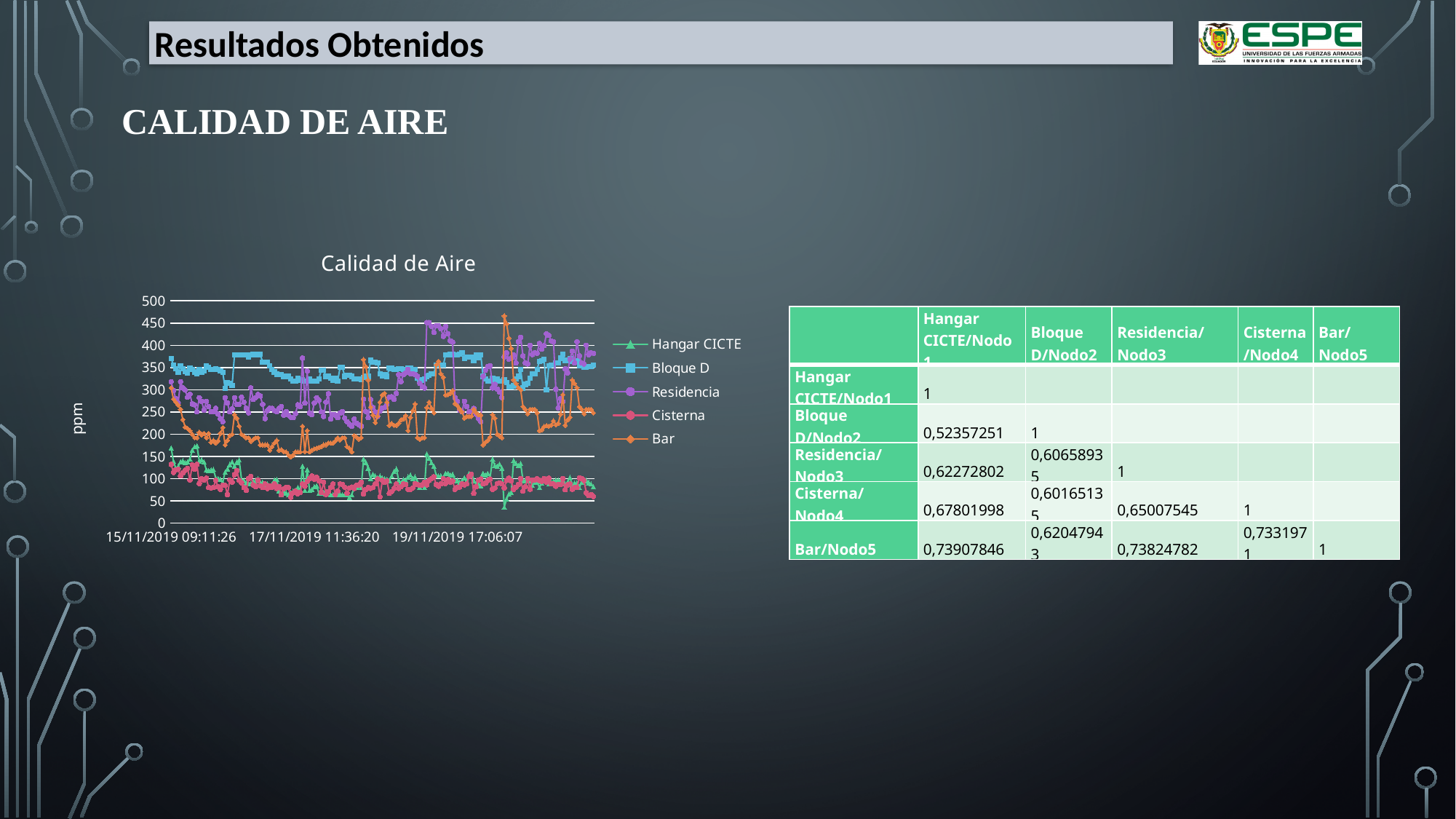
What kind of chart is shown on the slide? line chart What label is shown on the vertical axis of the chart? ppm How many date labels are shown on the horizontal axis of the chart? 3 At the start of the chart, which series has the larger value, Bloque D or Cisterna? Bloque D Is the value for Bloque D at the start of the chart greater or less than 300? greater Is the value for Bar at the start of the chart greater or less than 150? greater What is the highest value shown on the vertical axis of the chart? 500 At the start of the chart, which series has the larger value, Residencia or Hangar CICTE? Residencia How many series does the legend of the Calidad de Aire chart list? 5 What is the first date label shown on the horizontal axis of the chart? 15/11/2019 09:11:26 What is the title of the chart on the slide? Calidad de Aire Is the value for Cisterna at the start of the chart greater or less than 200? less